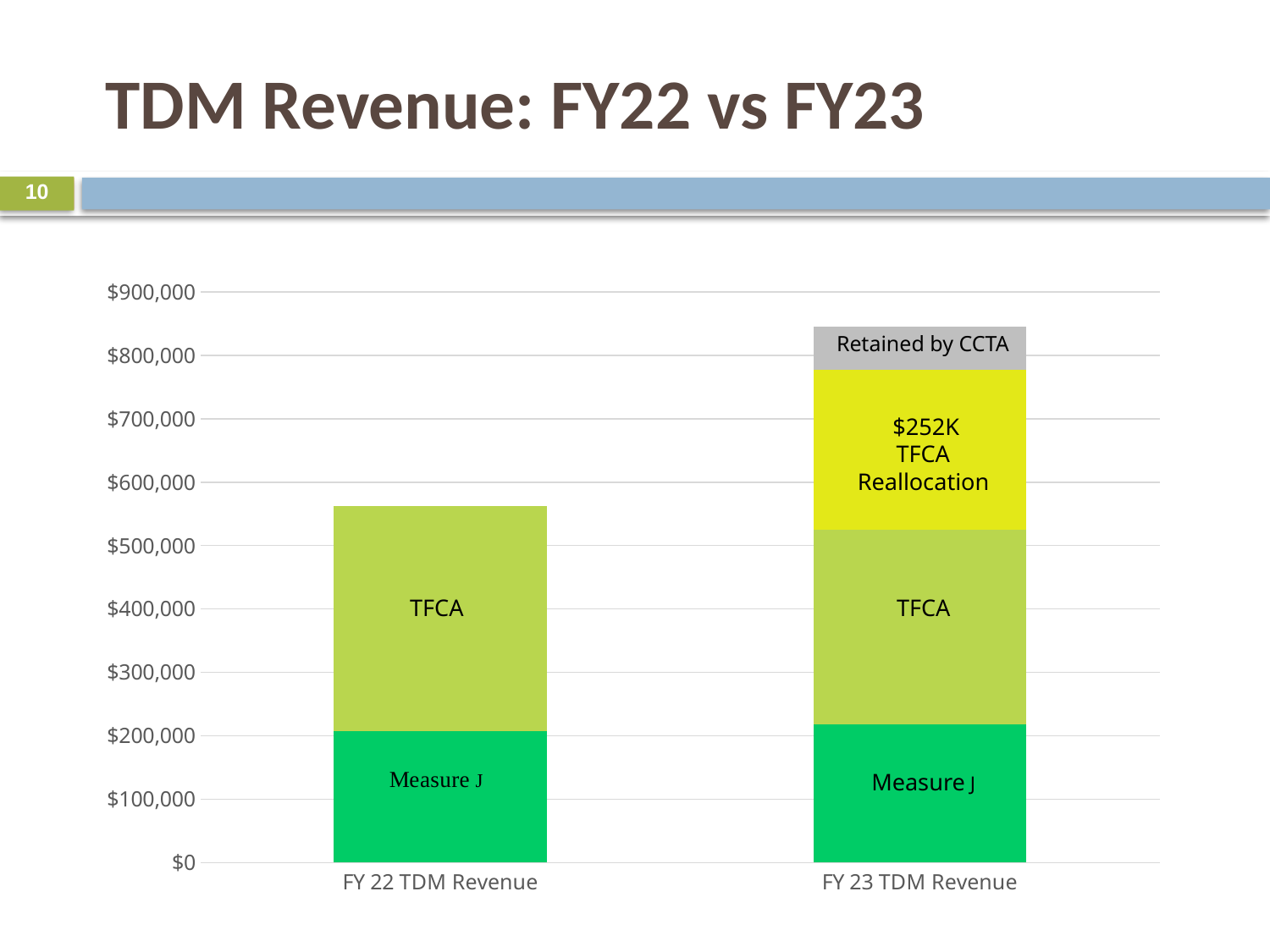
Is the total for FY 23 TDM Revenue greater or less than $800,000? greater Is the total for FY 23 TDM Revenue greater or less than $900,000? less Does total TDM revenue rise or fall from FY 22 to FY 23? rise Is the total for FY 22 TDM Revenue greater or less than $600,000? less Which bar is taller, FY 22 TDM Revenue or FY 23 TDM Revenue? FY 23 TDM Revenue What value is printed on the yellow TFCA Reallocation segment of the FY 23 bar? $252K What is the title of the chart slide? TDM Revenue: FY22 vs FY23 What kind of chart is shown on the slide? Stacked bar chart Which category has the lowest total revenue? FY 22 TDM Revenue How many bars (categories) are plotted on the chart? 2 Which segment appears only in the FY 23 bar at the very top, shown in gray? Retained by CCTA